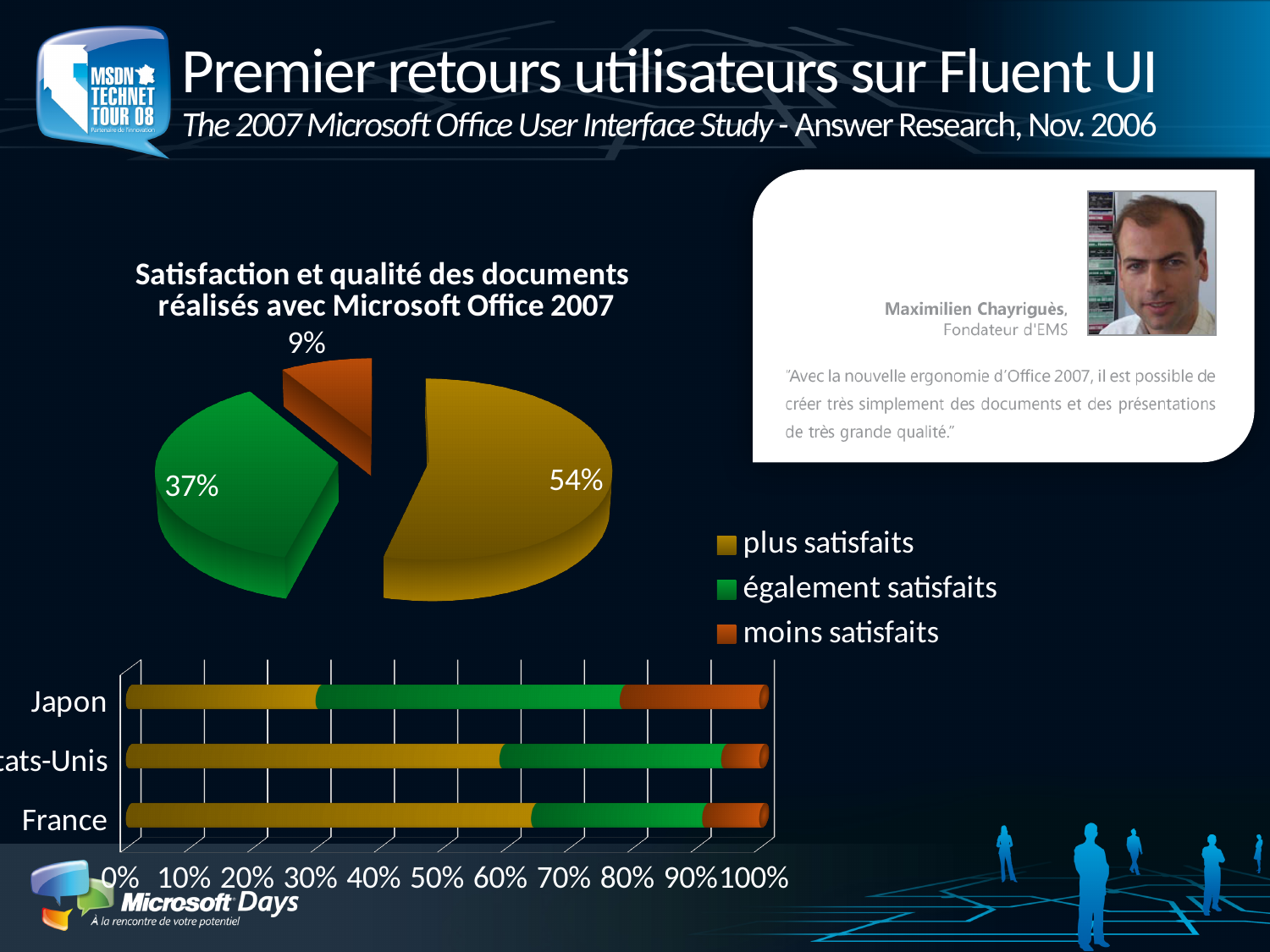
In the pie chart, what is the difference between the 'plus satisfaits' and 'également satisfaits' shares? 17% In the pie chart, which is larger: the 'également satisfaits' slice or the 'moins satisfaits' slice? également satisfaits How many series does the legend list? 3 What kind of chart is the chart at the bottom of the slide? bar chart In the pie chart, what share of respondents are 'moins satisfaits'? 9% In the pie chart, which category has the smallest slice? moins satisfaits In the pie chart, which category has the largest slice? plus satisfaits In the pie chart, what share of respondents are 'également satisfaits'? 37% In the bar chart at the bottom, is the 'plus satisfaits' value for Japon greater or less than 40%? less In the pie chart, what share of respondents are 'plus satisfaits'? 54% In the bar chart at the bottom, how many countries are shown? 3 What is the title of the pie chart? Satisfaction et qualité des documents réalisés avec Microsoft Office 2007